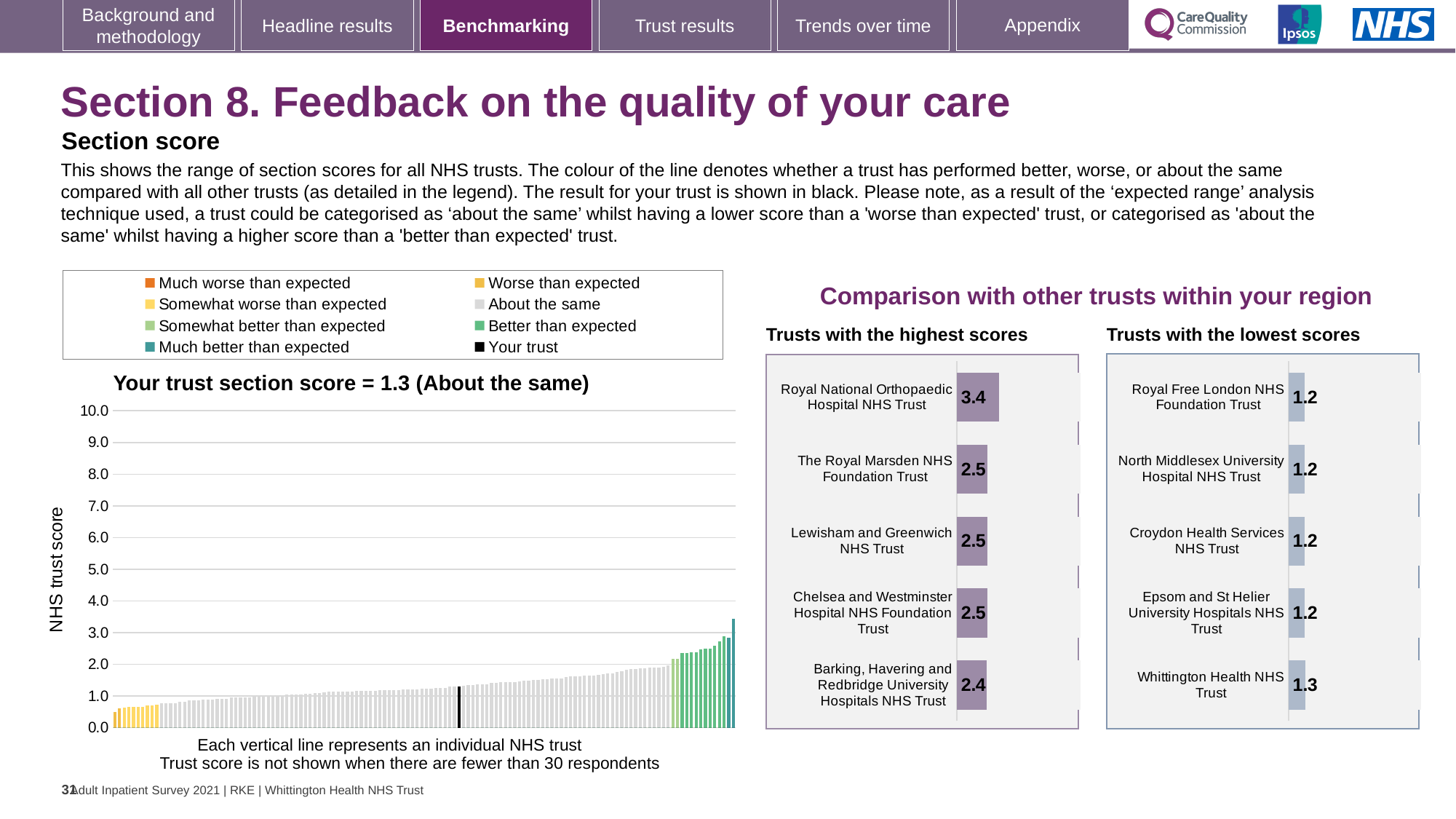
In the 'Trusts with the highest scores' chart, what is the score for Barking, Havering and Redbridge University Hospitals NHS Trust? 2.4 In the 'Trusts with the lowest scores' chart, what is the score for Whittington Health NHS Trust? 1.3 How many trusts are shown in the 'Trusts with the highest scores' chart? 5 In the 'Trusts with the lowest scores' chart, what is the difference between the scores of Whittington Health NHS Trust and Royal Free London NHS Foundation Trust? 0.1 How many entries does the legend above the 'Your trust section score' chart list? 8 In the 'Trusts with the highest scores' chart, what is the difference between the scores of Royal National Orthopaedic Hospital NHS Trust and Barking, Havering and Redbridge University Hospitals NHS Trust? 1.0 In the 'Trusts with the lowest scores' chart, what is the score for Croydon Health Services NHS Trust? 1.2 In the 'Trusts with the highest scores' chart, which trust has the highest score? Royal National Orthopaedic Hospital NHS Trust In the 'Your trust section score' chart, what is the section score for your trust? 1.3 In the 'Trusts with the highest scores' chart, what is the score for Royal National Orthopaedic Hospital NHS Trust? 3.4 In the 'Trusts with the lowest scores' chart, which trust has the highest score? Whittington Health NHS Trust What kind of chart is the 'Your trust section score' chart? bar chart